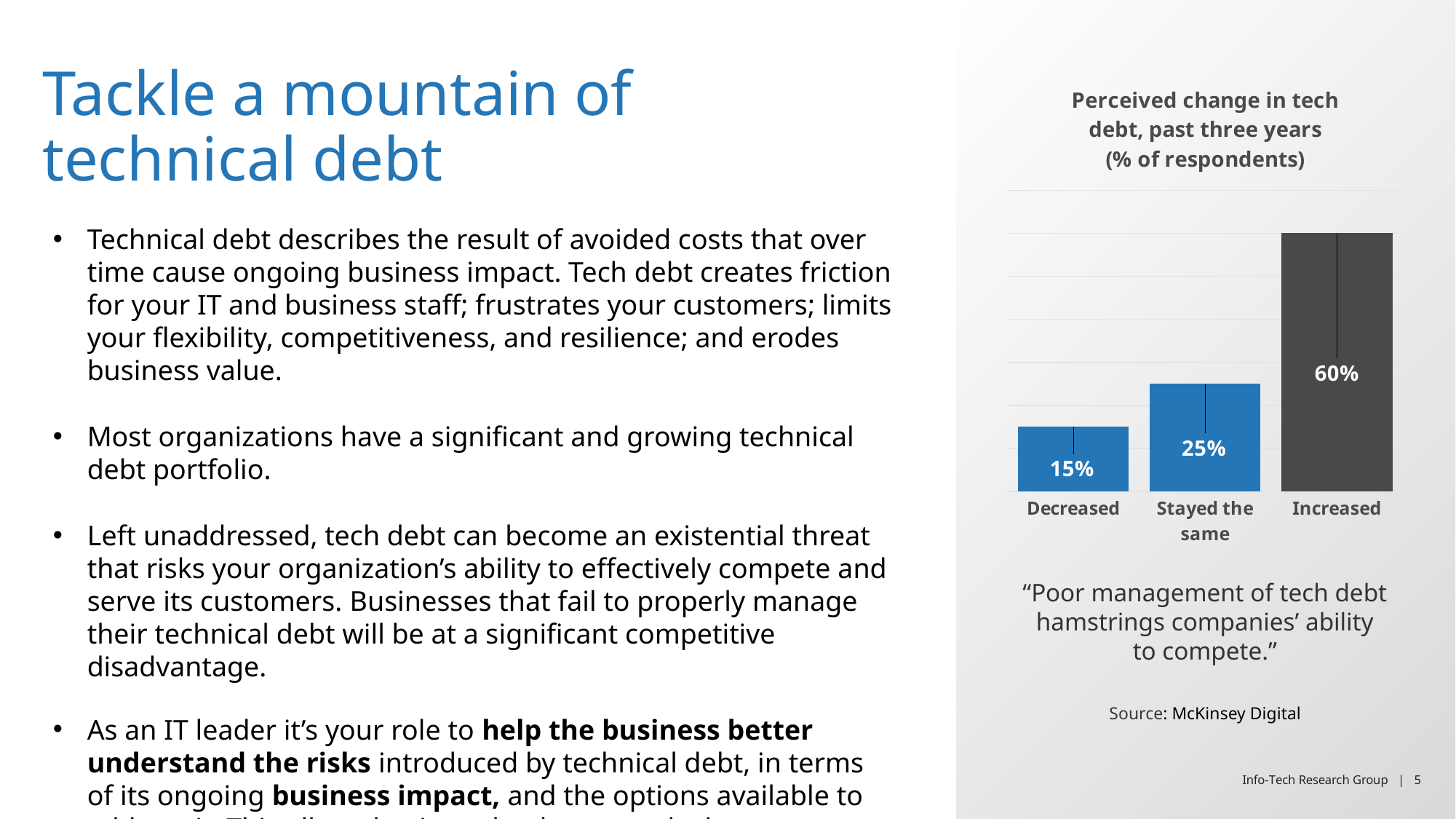
What is the source cited for the chart? McKinsey Digital How many categories are shown in the chart? 3 What percentage of respondents said tech debt Increased? 60% Which category has the lowest value? Decreased What percentage of respondents said tech debt Stayed the same? 25% What percentage of respondents said tech debt Decreased? 15% What is the title of the chart? Perceived change in tech debt, past three years (% of respondents) What is the difference between the Increased and Decreased values? 45% What is the difference between the Stayed the same and Decreased values? 10% What kind of chart is shown on the slide? Bar chart Which category has the highest value? Increased Which is larger, the value for Stayed the same or the value for Decreased? Stayed the same